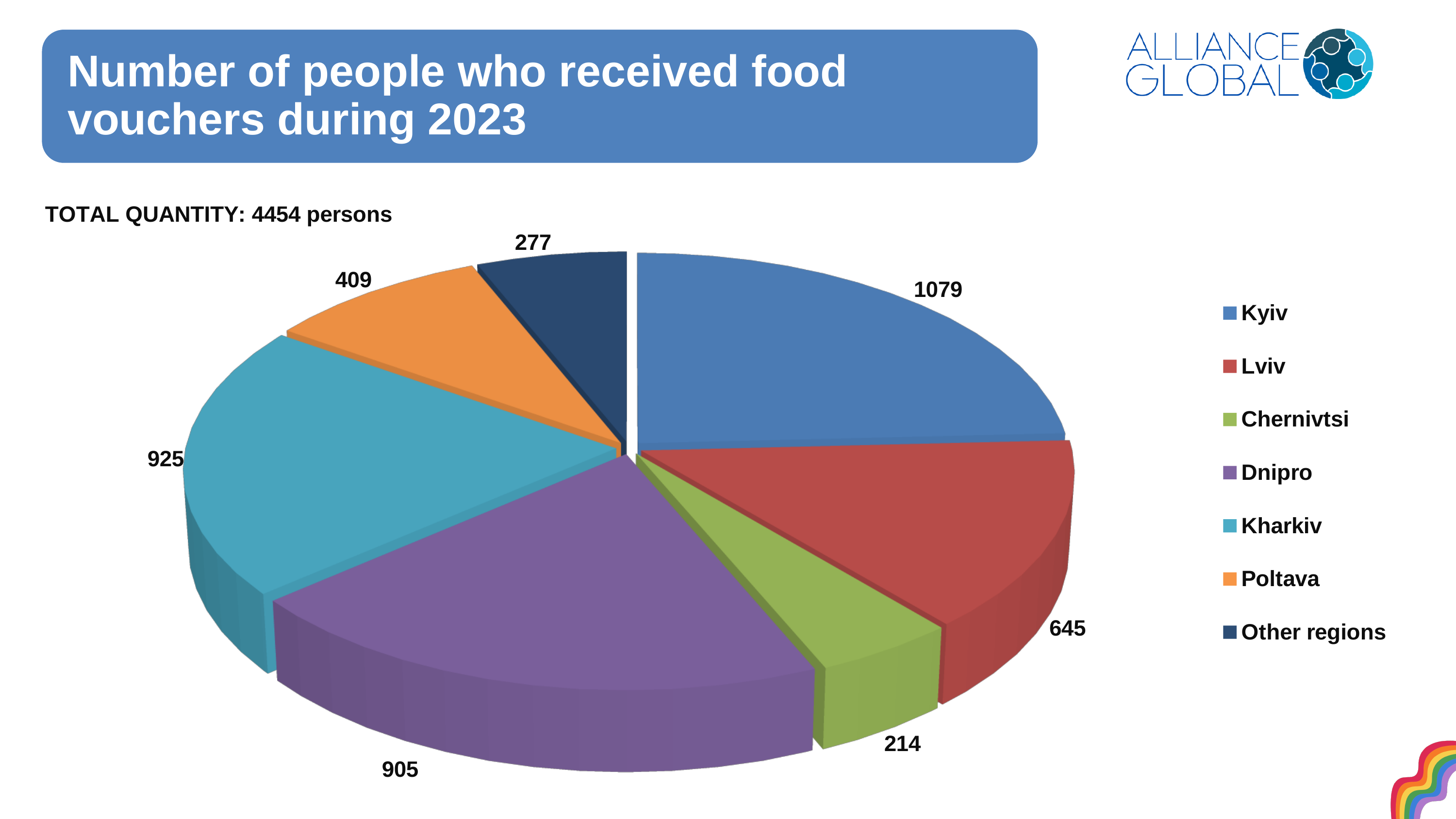
How many people in Kyiv received food vouchers during 2023? 1079 Which region has the smallest slice of the pie? Chernivtsi What type of chart is shown on the slide? pie chart What is the difference between the values for Kyiv and Lviv? 434 What total quantity of persons is stated on the slide? 4454 persons Which region has the largest slice of the pie? Kyiv What is the value for Lviv? 645 Which legend entry is shown in dark navy blue? Other regions Which is larger, the value for Kharkiv or the value for Dnipro? Kharkiv How many slices does the pie chart have? 7 What is the value for Poltava? 409 What is the value for Chernivtsi? 214